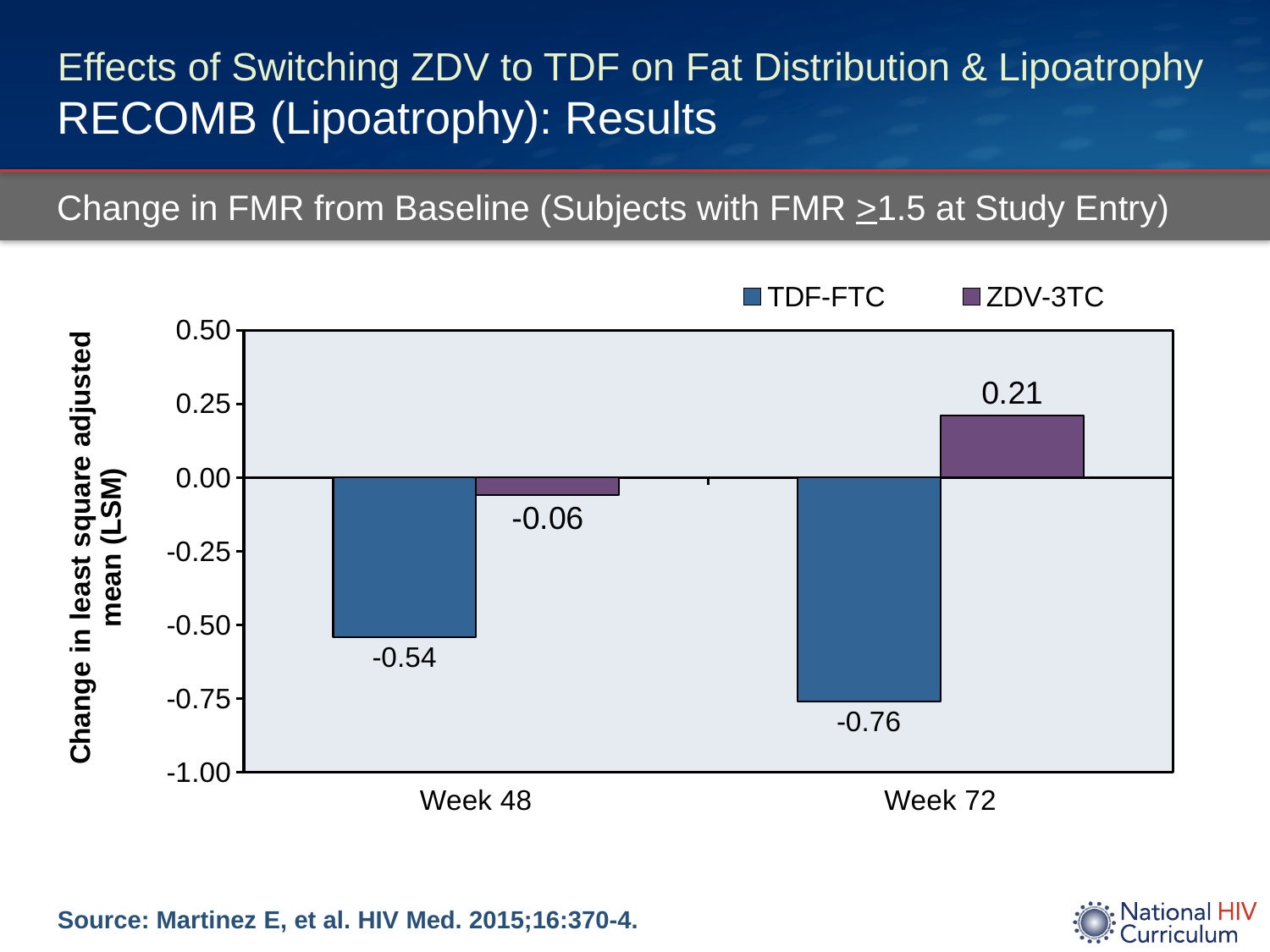
Which series has the lowest value on the chart? TDF-FTC at Week 72 How many time points are shown on the x axis? 2 What is the change in least square adjusted mean for TDF-FTC at Week 48? -0.54 What is the value for TDF-FTC at Week 72? -0.76 What is the label of the y axis? Change in least square adjusted mean (LSM) What is the change in least square adjusted mean for ZDV-3TC at Week 72? 0.21 How many series does the legend list? 2 Which is larger at Week 48, the value for TDF-FTC or for ZDV-3TC? ZDV-3TC What kind of chart is shown on the slide? Bar chart Which series has the highest value on the chart? ZDV-3TC at Week 72 What is the difference between the TDF-FTC values at Week 48 and Week 72? 0.22 What is the value for ZDV-3TC at Week 48? -0.06